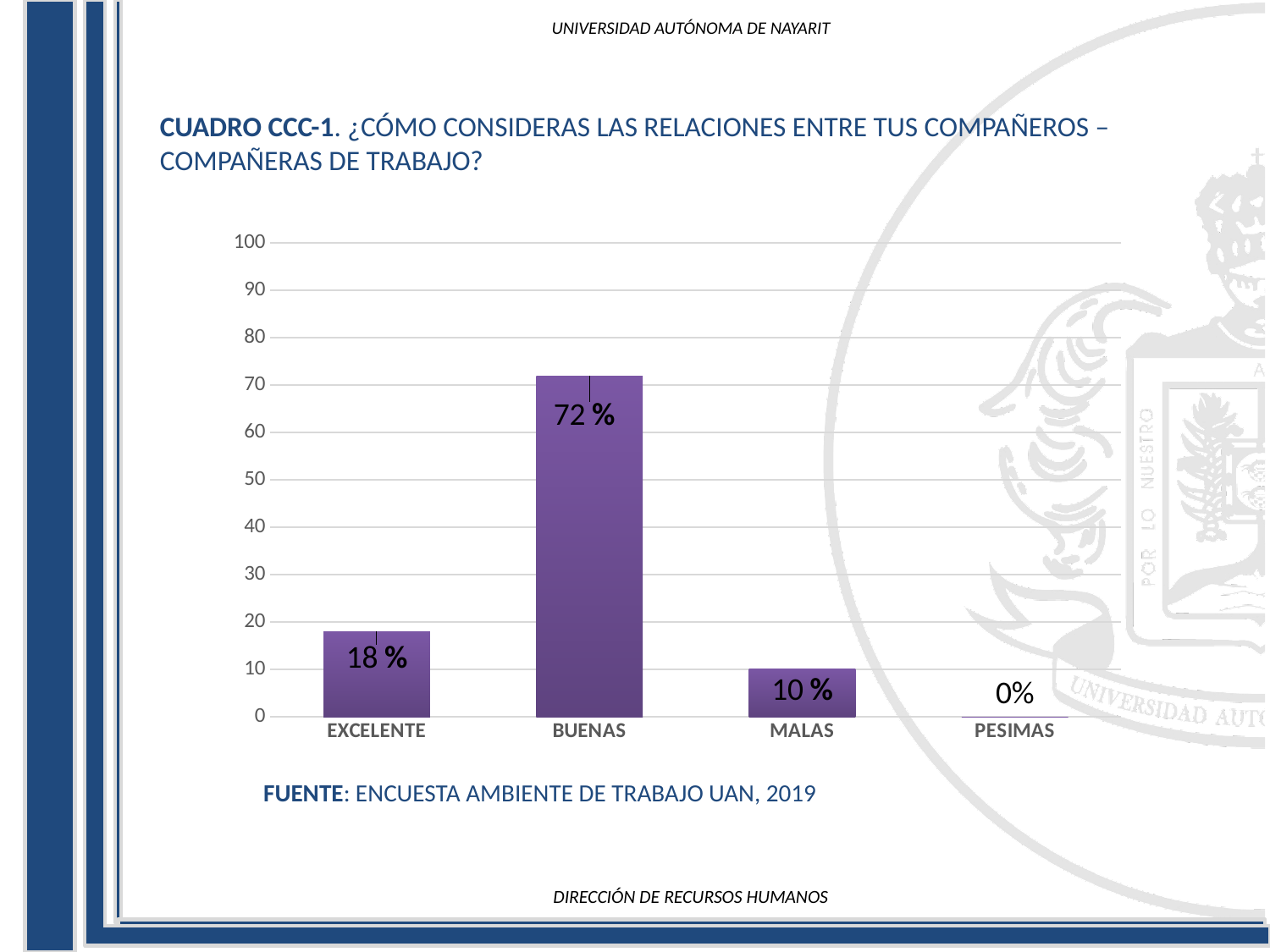
Which category has the lowest value? PESIMAS Is the value for BUENAS greater or less than 50? greater What is the value for BUENAS? 72 % What is the value for PESIMAS? 0% What is the difference between the values for BUENAS and EXCELENTE? 54 % What is the value for MALAS? 10 % How many categories are shown on the x axis? 4 Which is larger, the value for EXCELENTE or the value for MALAS? EXCELENTE What kind of chart is shown on the slide? bar chart What is the value for EXCELENTE? 18 % What source is cited below the chart? ENCUESTA AMBIENTE DE TRABAJO UAN, 2019 Which category has the highest value? BUENAS